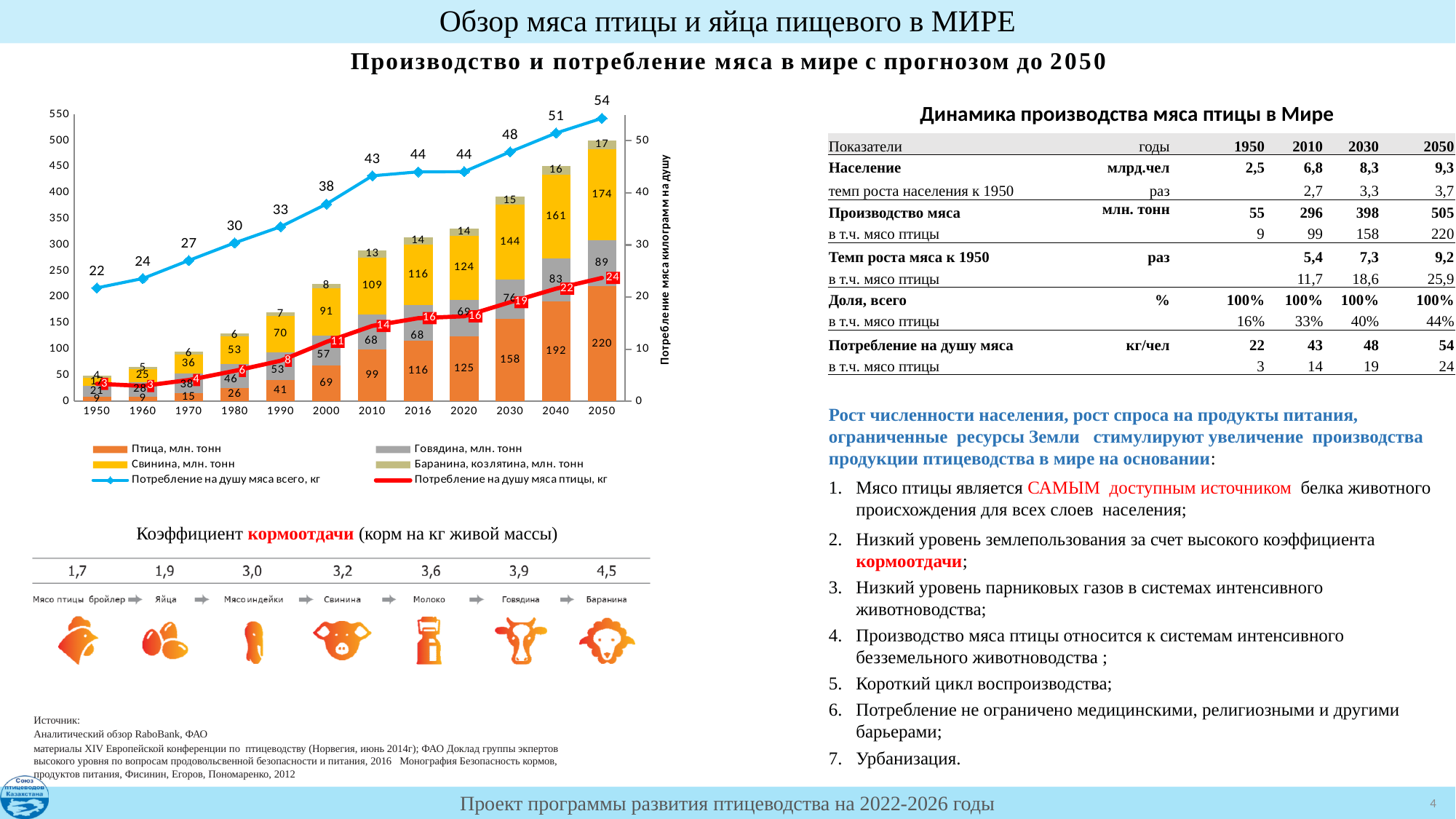
What is the value of Потребление на душу мяса всего, кг for 2030? 48 What is the difference between the Птица, млн. тонн values for 2050 and 2010? 121 What is the value of Свинина, млн. тонн for 2000? 91 What kind of chart is shown on the left of the slide? stacked bar chart with line series In which year is the value of Говядина, млн. тонн the lowest? 1950 In 2050, which is larger: Свинина, млн. тонн or Говядина, млн. тонн? Свинина, млн. тонн What is the value of Потребление на душу мяса птицы, кг for 2040? 22 Does the Потребление на душу мяса всего, кг line rise or fall from 1950 to 2050? rise What is the value of Птица, млн. тонн for 2050? 220 How many years (categories) are shown on the x axis of the chart? 12 In which year is the value of Птица, млн. тонн the highest? 2050 How many series does the chart legend list? 6